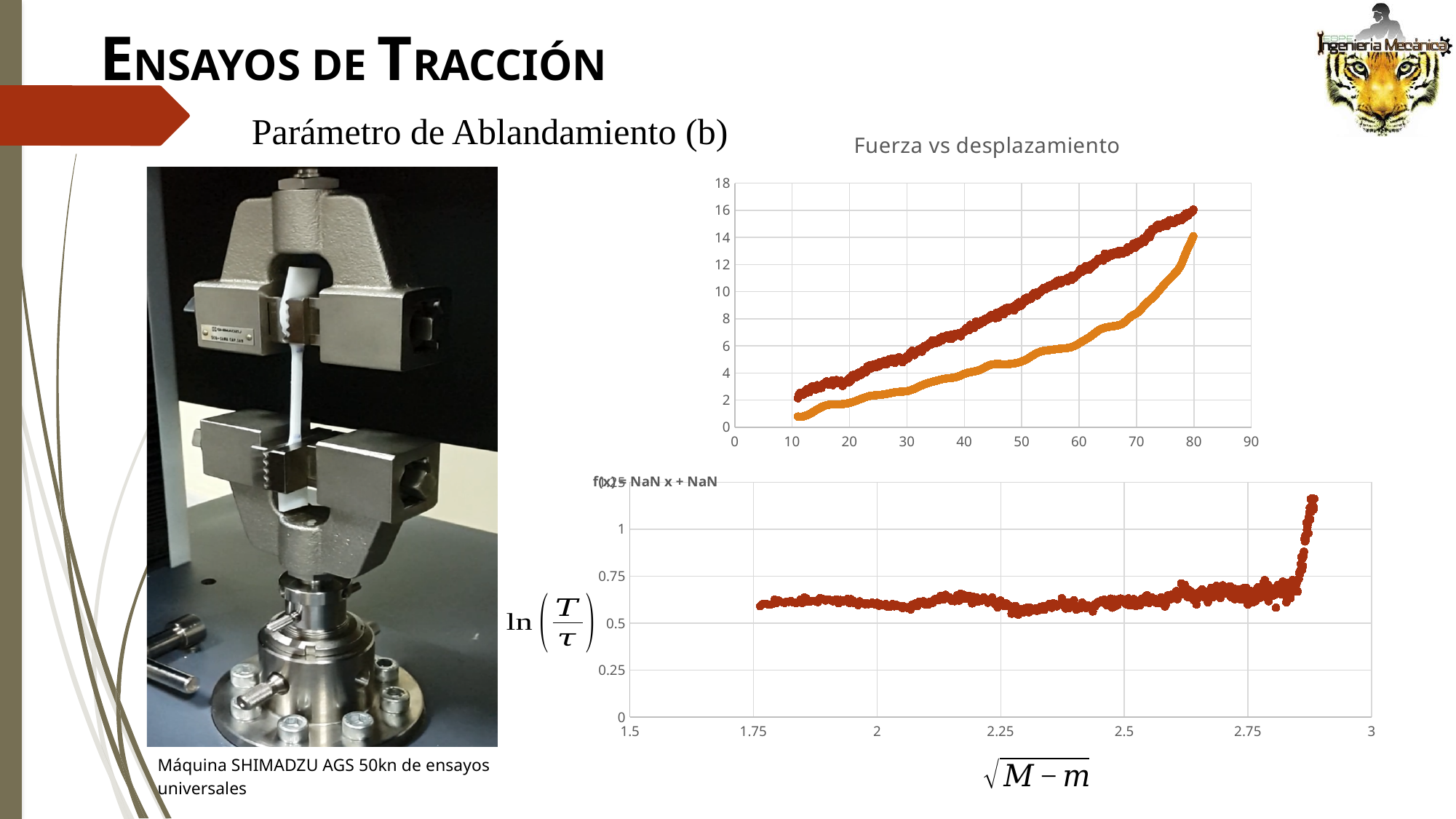
In the 'Fuerza vs desplazamiento' chart, is the value of the orange series at x = 10 greater or less than 2? less In the lower chart with the y axis labelled ln(T/τ), how do the values behave along the x axis? roughly flat, then rise sharply at the end In the 'Fuerza vs desplazamiento' chart, is the value of the dark red series at x = 10 greater or less than 4? less In the 'Fuerza vs desplazamiento' chart, is the value of the dark red series at x = 80 greater or less than 14? greater In the 'Fuerza vs desplazamiento' chart, what is the highest value shown on the y axis? 18 What trendline equation is printed on the lower chart with the y axis labelled ln(T/τ)? f(x) = NaN x + NaN In the 'Fuerza vs desplazamiento' chart, do the values rise or fall as the x axis increases? rise What kind of chart is the lower chart with the y axis labelled ln(T/τ)? scatter chart In the 'Fuerza vs desplazamiento' chart, at x = 50, which series has the higher value, the dark red one or the orange one? the dark red one What kind of chart is the 'Fuerza vs desplazamiento' chart? scatter chart